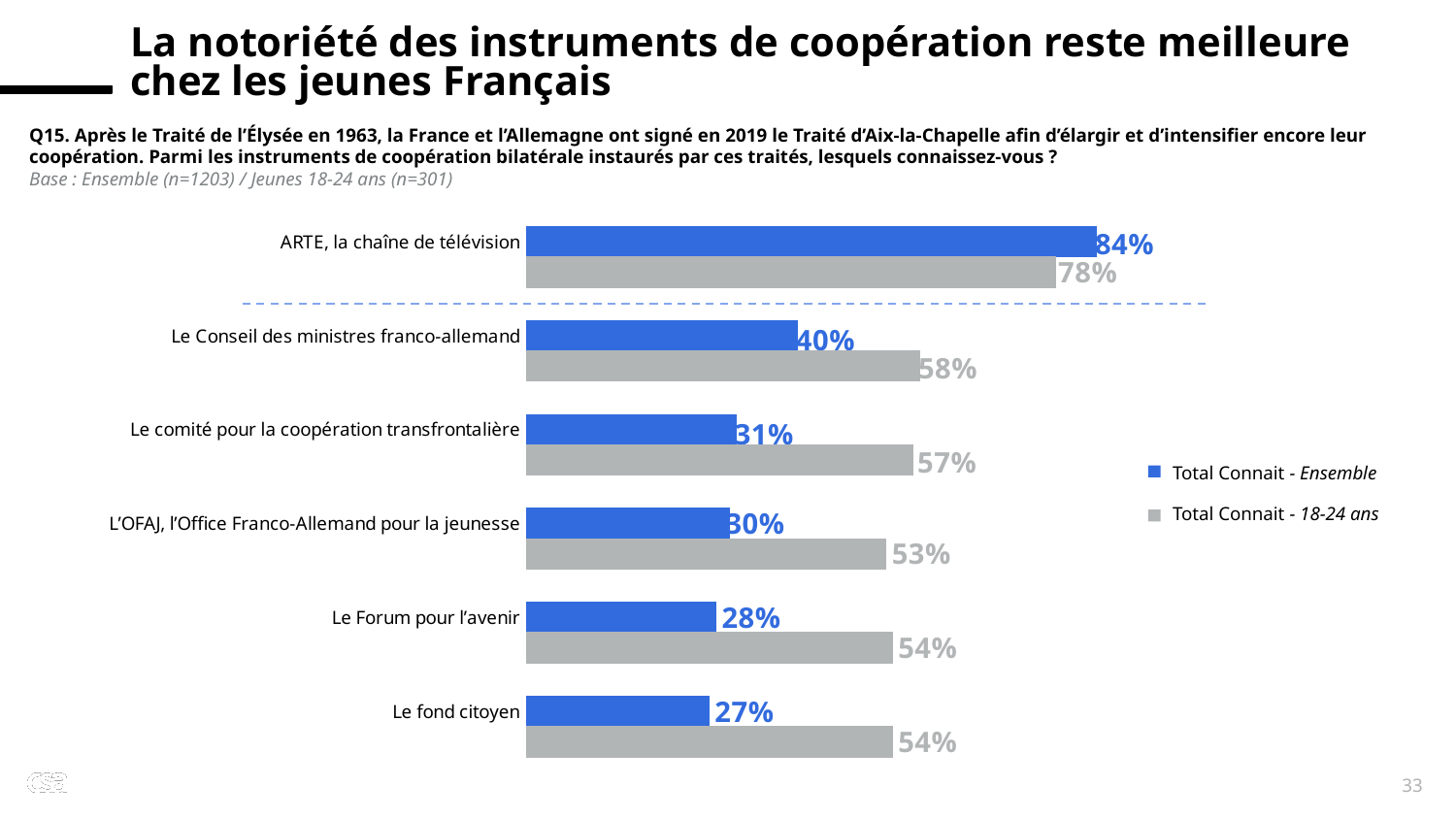
How many series does the legend list? 2 What is the value for ARTE, la chaîne de télévision in the Total Connait - Ensemble series? 84% Which colour represents the Total Connait - 18-24 ans series? Grey What kind of chart is shown on the slide? Bar chart What is the value for Le Conseil des ministres franco-allemand in the Total Connait - 18-24 ans series? 58% What is the difference between the Total Connait - 18-24 ans value and the Total Connait - Ensemble value for Le comité pour la coopération transfrontalière? 26 percentage points What is the value for Le fond citoyen in the Total Connait - Ensemble series? 27% How many categories are shown in the chart? 6 Which category has the lowest value in the Total Connait - Ensemble series? Le fond citoyen For L'OFAJ, l'Office Franco-Allemand pour la jeunesse, which series has the larger value: Total Connait - Ensemble or Total Connait - 18-24 ans? Total Connait - 18-24 ans For ARTE, la chaîne de télévision, which series has the larger value: Total Connait - Ensemble or Total Connait - 18-24 ans? Total Connait - Ensemble Which category has the highest value in the Total Connait - 18-24 ans series? ARTE, la chaîne de télévision